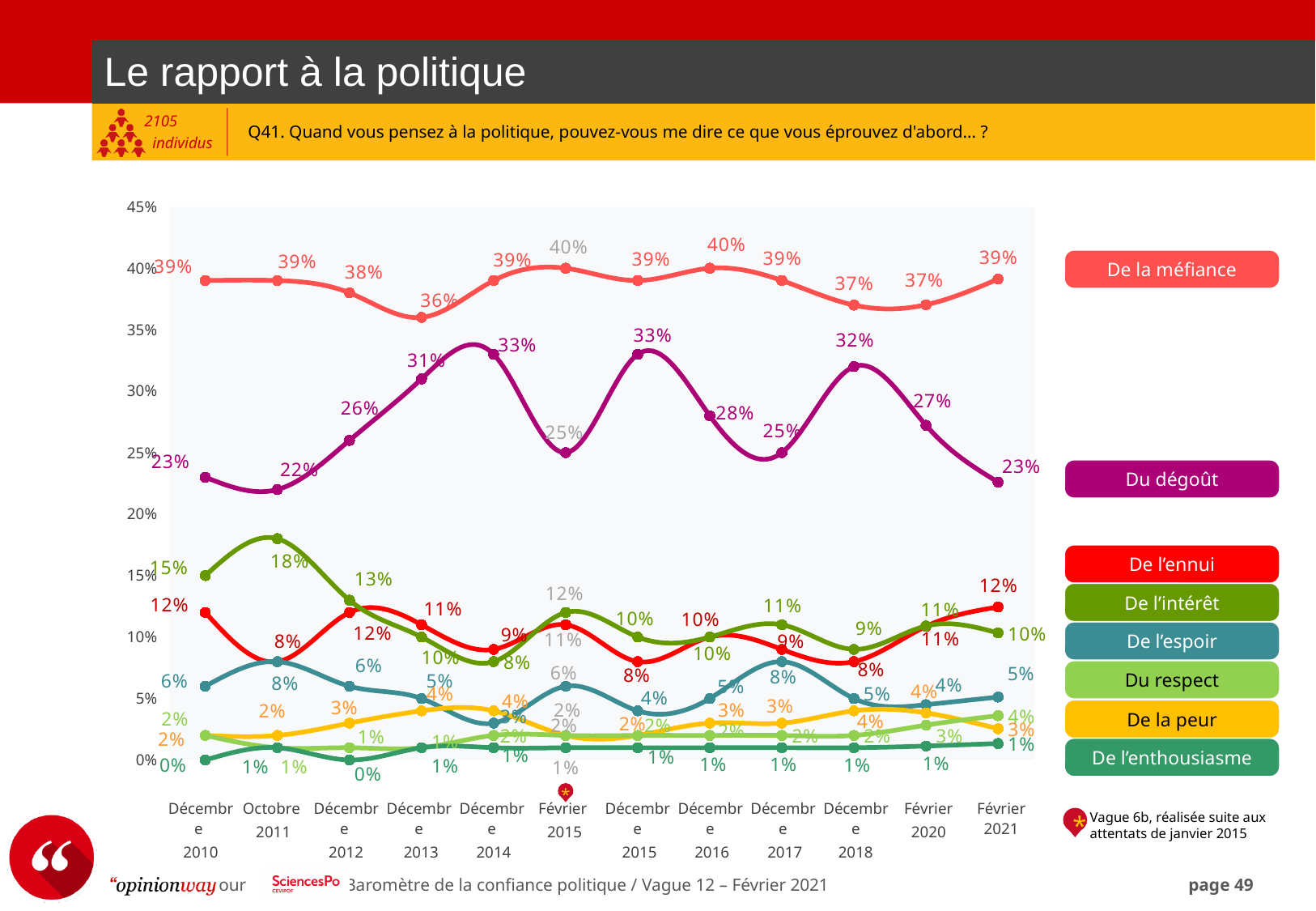
How many time points are shown on the x axis? 12 What is the value for 'De l'intérêt' in Octobre 2011? 18% How many series does the legend list? 8 Which series has the highest value in Février 2021? De la méfiance What type of chart is shown on the slide? line chart What is the value for 'Du dégoût' in Décembre 2014? 33% Does 'Du dégoût' rise or fall between Décembre 2018 and Février 2021? fall Is the value for 'Du dégoût' in Décembre 2018 greater or less than 30%? greater What is the value for 'De l'ennui' in Février 2021? 12% Which is larger in Décembre 2013: 'Du dégoût' or 'De l'intérêt'? Du dégoût What is the difference between 'De la méfiance' and 'Du dégoût' in Février 2021? 16 percentage points What is the value for 'De la méfiance' in Février 2021? 39%